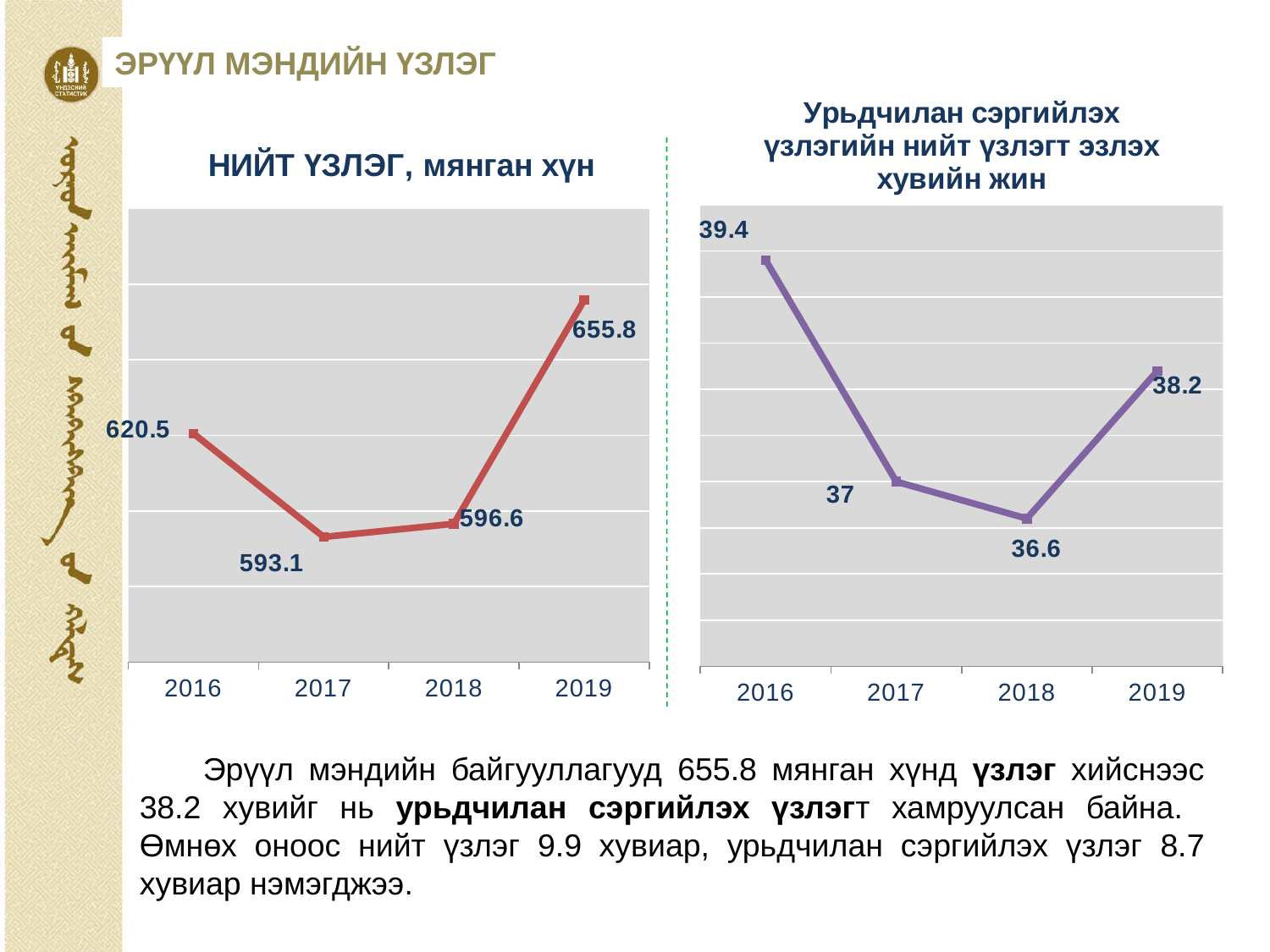
In the left chart titled 'НИЙТ ҮЗЛЭГ, мянган хүн', which year has the lowest value? 2017 In the right chart titled 'Урьдчилан сэргийлэх үзлэгийн нийт үзлэгт эзлэх хувийн жин', what is the value for 2016? 39.4 In the right chart titled 'Урьдчилан сэргийлэх үзлэгийн нийт үзлэгт эзлэх хувийн жин', what is the value for 2018? 36.6 In the left chart titled 'НИЙТ ҮЗЛЭГ, мянган хүн', how many years are plotted? 4 In the right chart titled 'Урьдчилан сэргийлэх үзлэгийн нийт үзлэгт эзлэх хувийн жин', is the value for 2019 larger or smaller than the value for 2017? larger In the left chart titled 'НИЙТ ҮЗЛЭГ, мянган хүн', which year has the highest value? 2019 In the right chart titled 'Урьдчилан сэргийлэх үзлэгийн нийт үзлэгт эзлэх хувийн жин', which year has the lowest value? 2018 What kind of chart is the left chart titled 'НИЙТ ҮЗЛЭГ, мянган хүн'? line chart In the left chart titled 'НИЙТ ҮЗЛЭГ, мянган хүн', what is the difference between the 2019 and 2016 values? 35.3 In the right chart titled 'Урьдчилан сэргийлэх үзлэгийн нийт үзлэгт эзлэх хувийн жин', what is the difference between the 2016 and 2018 values? 2.8 In the left chart titled 'НИЙТ ҮЗЛЭГ, мянган хүн', what is the value for 2019? 655.8 In the left chart titled 'НИЙТ ҮЗЛЭГ, мянган хүн', what is the value for 2017? 593.1